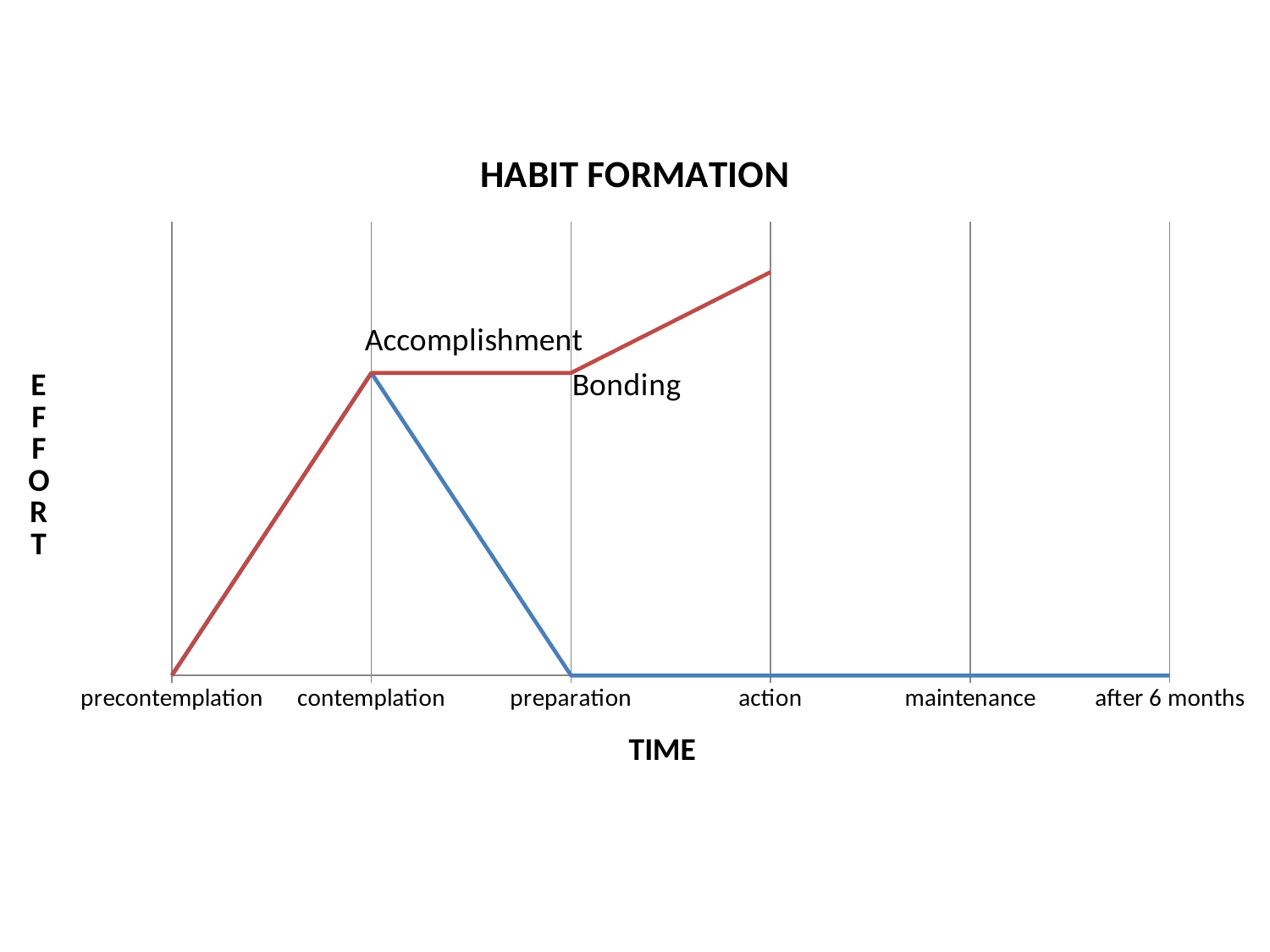
Does the blue line rise, fall or stay flat from preparation to after 6 months? Stay flat What is the title of the chart? HABIT FORMATION What is the label of the x axis? TIME At which category does the red line reach its highest point? action Does the red line rise or fall from preparation to action? Rise At which category does the blue line reach its highest point? contemplation Which is the last category on the x axis? after 6 months Does the red line rise or fall from precontemplation to contemplation? Rise How many categories are shown along the x axis? 6 What kind of chart is shown on the slide? Line chart At action, which line is higher, the red line or the blue line? Red line